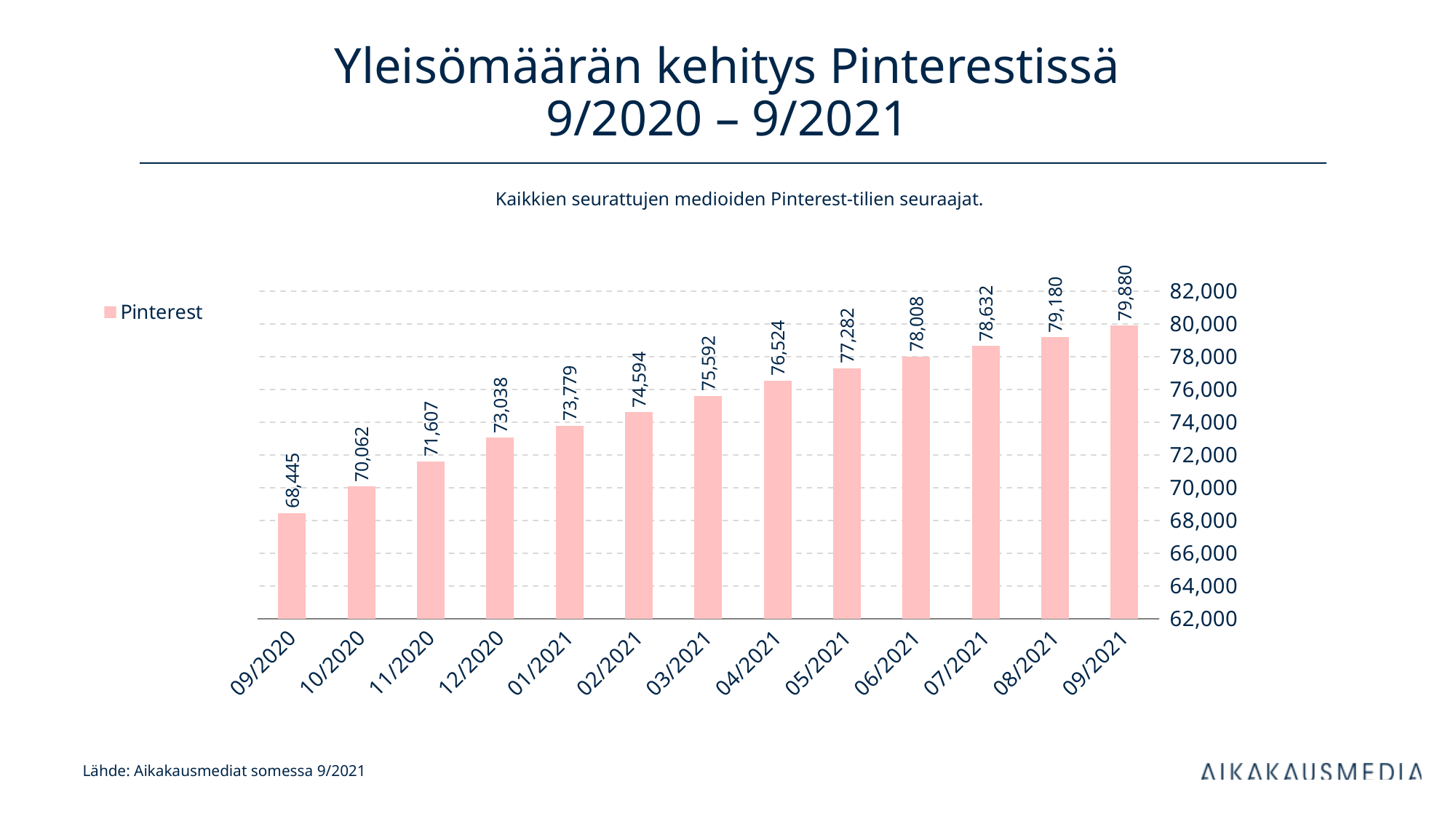
Which is larger, the value for 06/2021 or the value for 04/2021? 06/2021 What is the value for 09/2020? 68,445 What kind of chart is shown? bar chart What is the value for 03/2021? 75,592 What is the difference between the values for 09/2021 and 09/2020? 11,435 How many months are shown on the x axis? 13 Is the value for 11/2020 greater or less than 72,000? less Which month has the highest value? 09/2021 What is the value for 09/2021? 79,880 Which month has the lowest value? 09/2020 What is the difference between the values for 01/2021 and 12/2020? 741 Do the values rise or fall from 09/2020 to 09/2021? rise